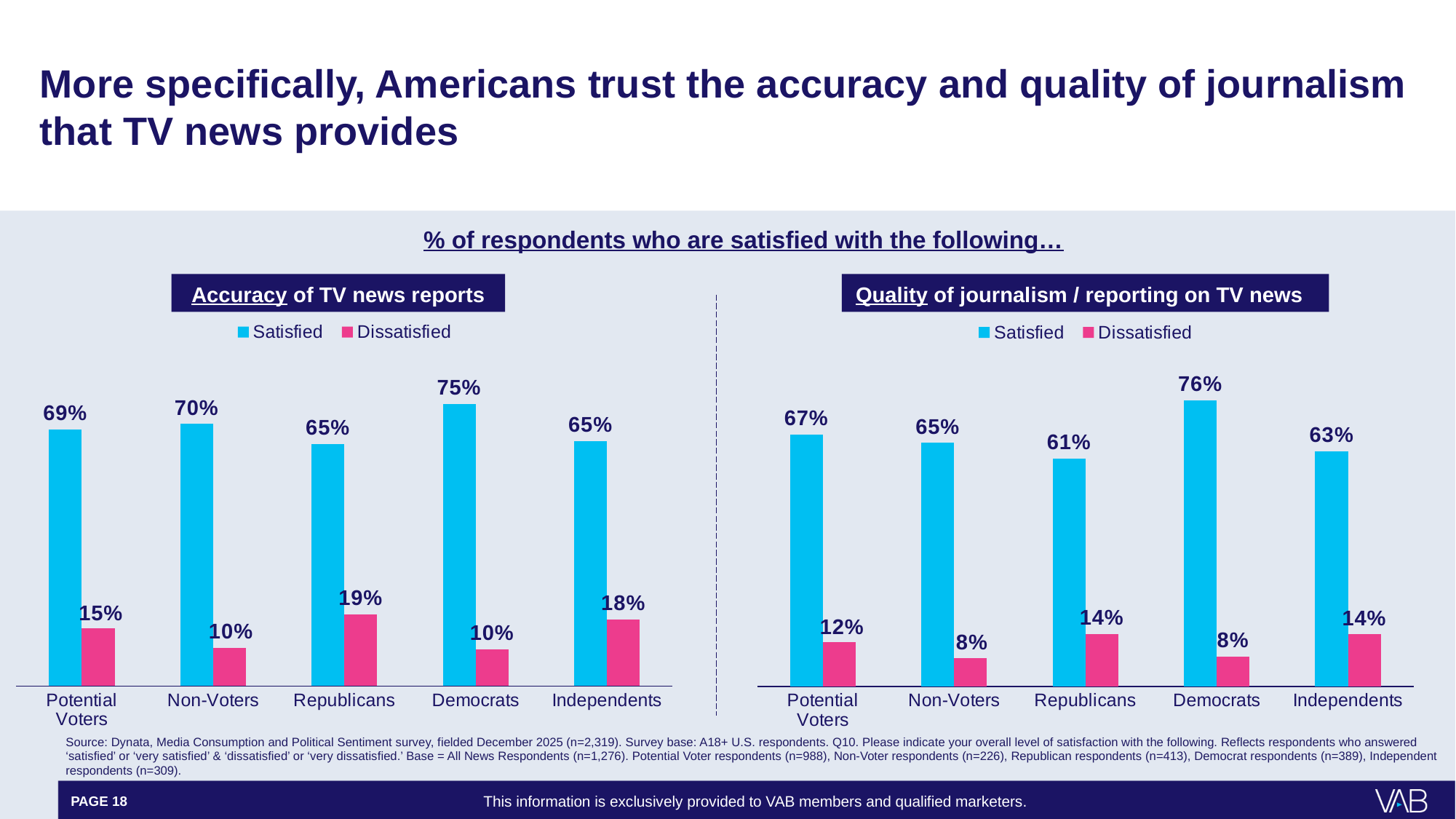
In the 'Accuracy of TV news reports' chart, what percentage of Republicans are dissatisfied? 19% In the 'Accuracy of TV news reports' chart, what percentage of Democrats are satisfied? 75% In the 'Quality of journalism / reporting on TV news' chart, which group has the lowest Satisfied value? Republicans What type of chart is the 'Accuracy of TV news reports' chart? Bar chart In the 'Accuracy of TV news reports' chart, which group has the highest Satisfied value? Democrats How many groups are shown on the x axis of the 'Quality of journalism / reporting on TV news' chart? 5 How many series does the legend of the 'Accuracy of TV news reports' chart list? 2 In the 'Quality of journalism / reporting on TV news' chart, what percentage of Potential Voters are satisfied? 67% In the 'Accuracy of TV news reports' chart, what is the difference between the Satisfied and Dissatisfied values for Potential Voters? 54 percentage points In the 'Quality of journalism / reporting on TV news' chart, what is the difference between the Satisfied values for Democrats and Republicans? 15 percentage points In the 'Quality of journalism / reporting on TV news' chart, what percentage of Non-Voters are dissatisfied? 8% In the 'Accuracy of TV news reports' chart, which is larger: the Dissatisfied value for Independents or for Non-Voters? Independents